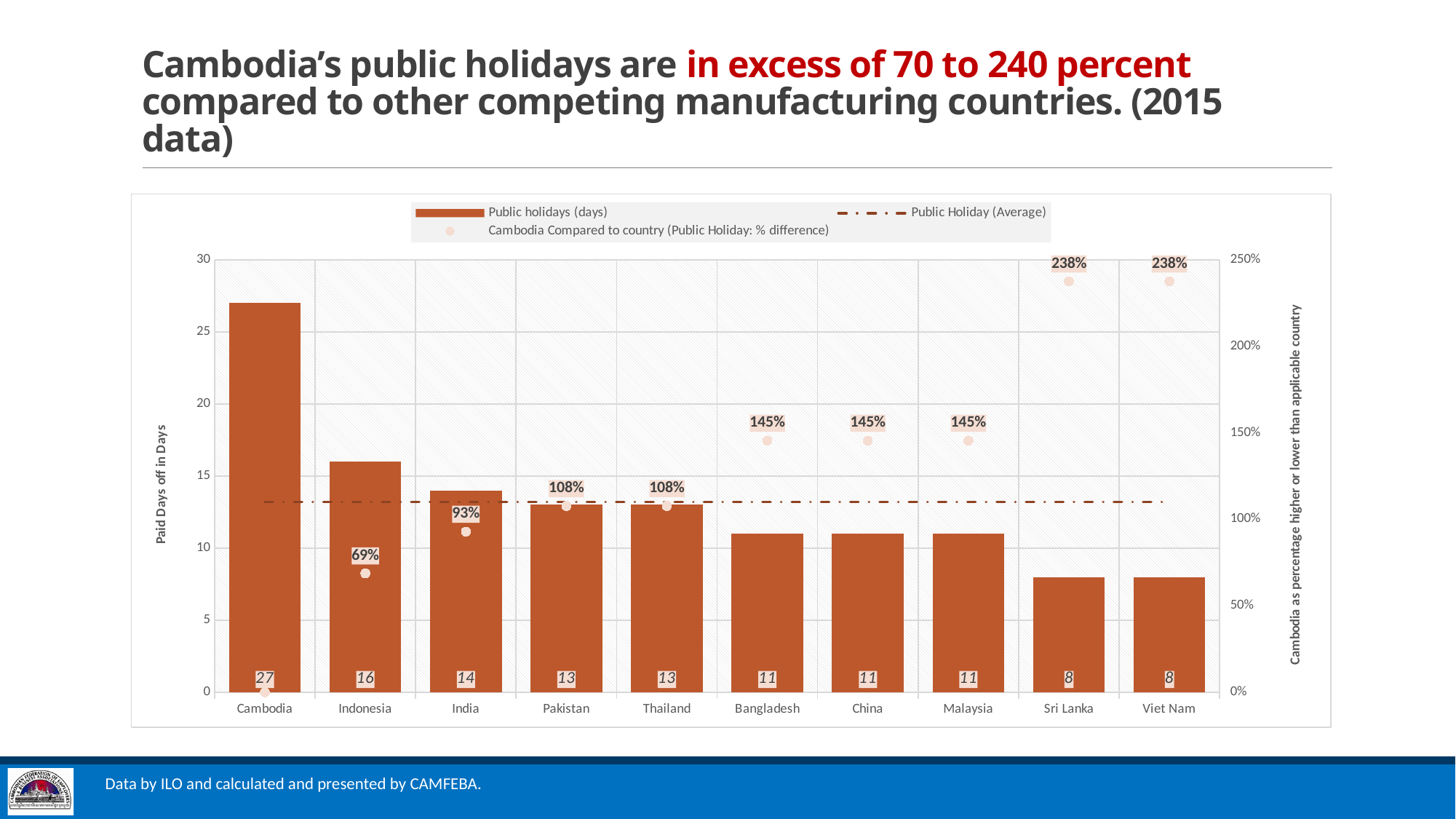
What is the difference in public holidays (days) between Cambodia and Viet Nam? 19 How many public holidays (days) does Indonesia have? 16 Which has more public holidays (days), India or Pakistan? India How many public holidays (days) does Cambodia have? 27 What is the 'Cambodia Compared to country (Public Holiday: % difference)' value for Bangladesh? 145% Which country has the lowest 'Cambodia Compared to country (Public Holiday: % difference)' value? Cambodia How many countries are shown on the x axis? 10 Is the Public Holiday (Average) line greater or less than 15 days? less What is the 'Cambodia Compared to country (Public Holiday: % difference)' value for Sri Lanka? 238% What is the label of the left vertical axis? Paid Days off in Days How many series does the legend list? 3 Which country has the highest number of public holidays (days)? Cambodia